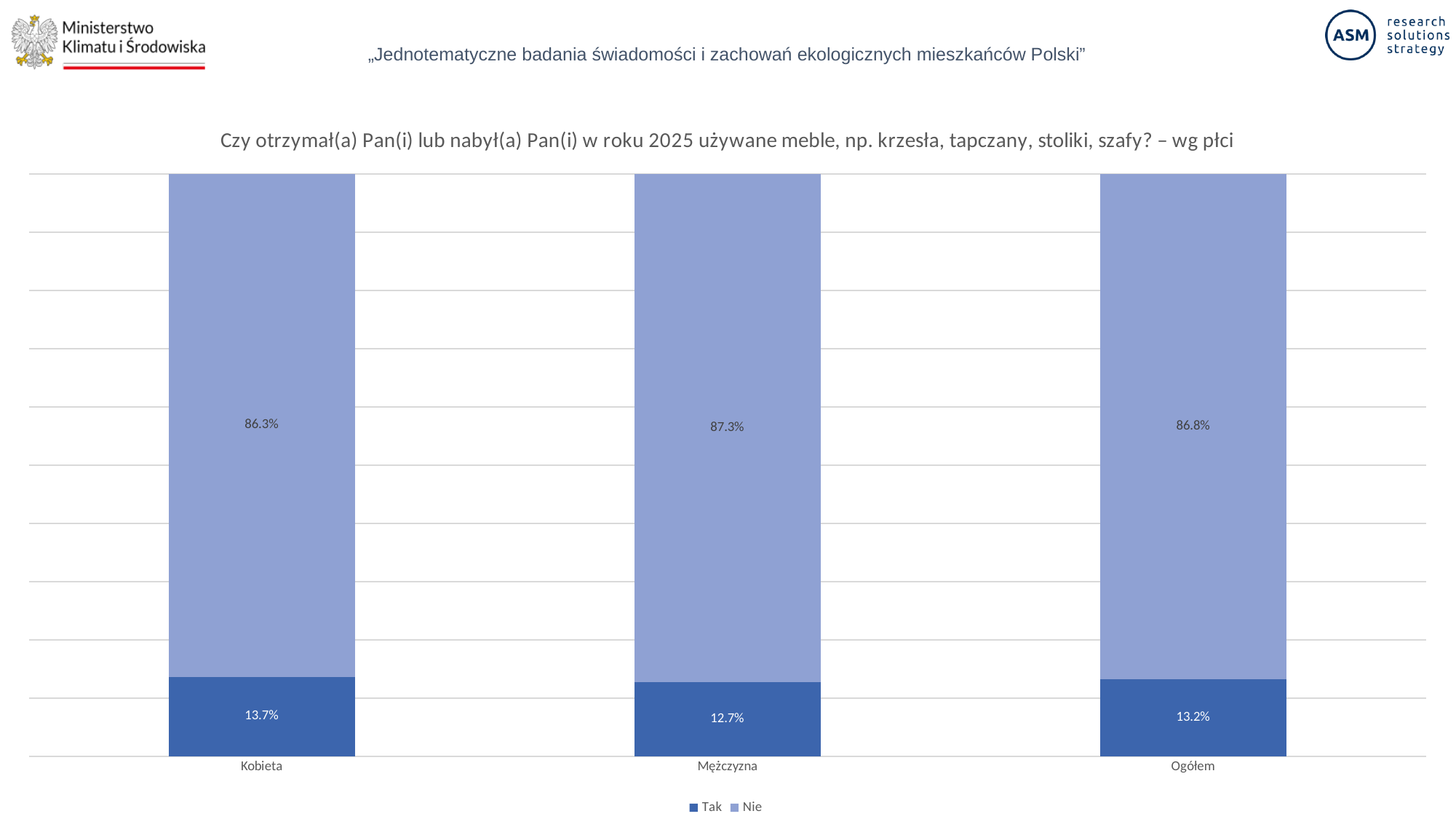
What is the total of the stacked bar for Mężczyzna? 100% What kind of chart is shown on the slide? Stacked bar chart What is the difference between the "Tak" values for Kobieta and Mężczyzna? 1.0% Which category has the highest "Nie" value? Mężczyzna What is the value for "Nie" for Mężczyzna? 87.3% How many categories are shown on the x axis? 3 How many series does the legend list? 2 What is the value for "Tak" for Ogółem? 13.2% What is the value for "Tak" for Kobieta? 13.7% What is the value for "Nie" for Kobieta? 86.3% Which is larger: the "Nie" value for Ogółem or the "Nie" value for Kobieta? Ogółem Which category has the lowest "Tak" value? Mężczyzna